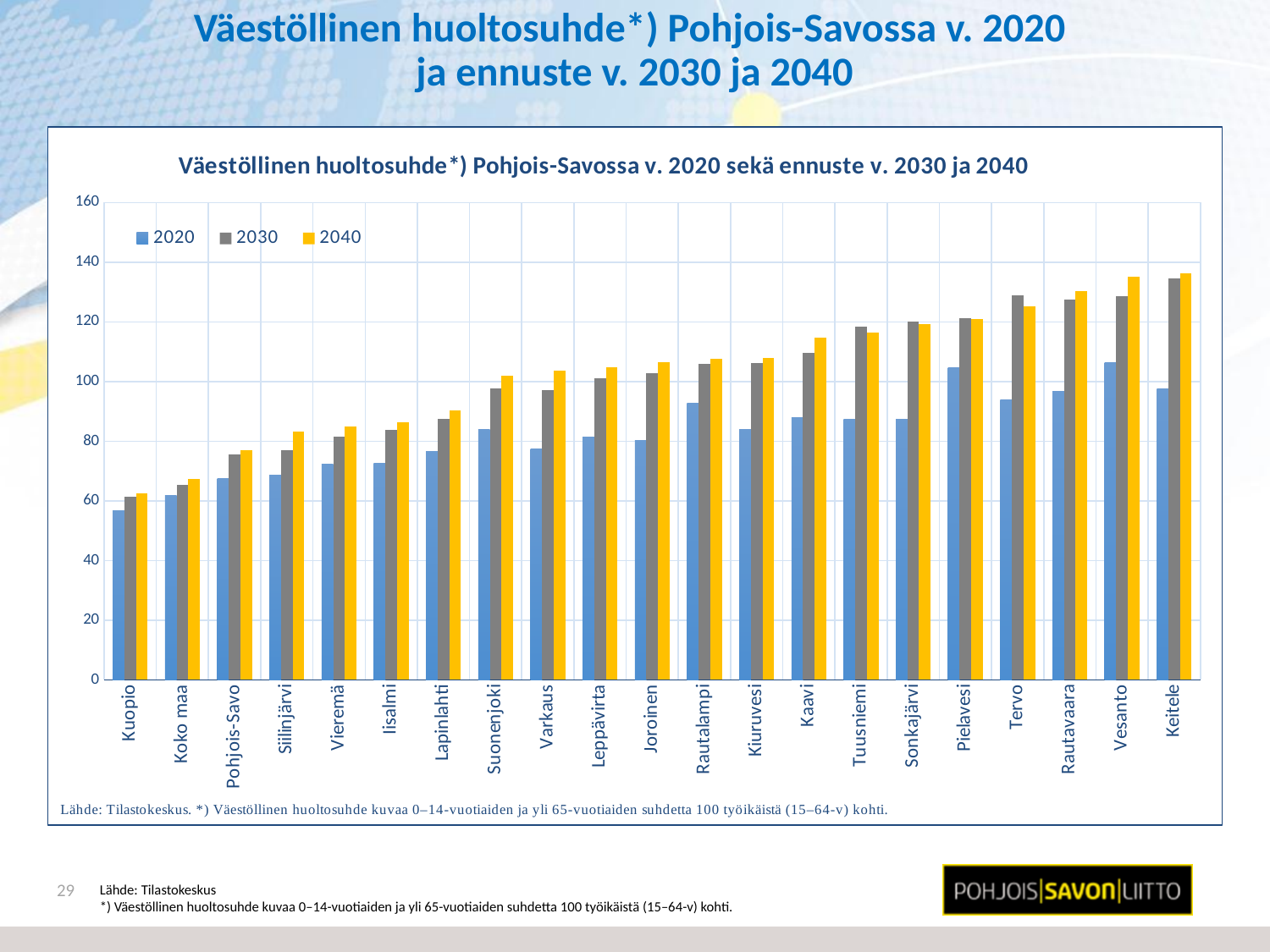
Which colour represents the 2040 series in the legend? yellow For Tervo, which is larger: the 2030 value or the 2040 value? 2030 Which category has the lowest value for 2040? Kuopio Is the 2040 value for Keitele greater or less than 120? greater Is the 2020 value for Kuopio greater or less than 60? less Do the values generally rise or fall moving from left to right along the x axis? rise Is the 2040 value for Kaavi greater or less than 100? greater What kind of chart is shown on the slide? bar chart How many series does the legend list? 3 Which category has the lowest value for 2020? Kuopio How many municipalities/areas are shown on the x axis? 21